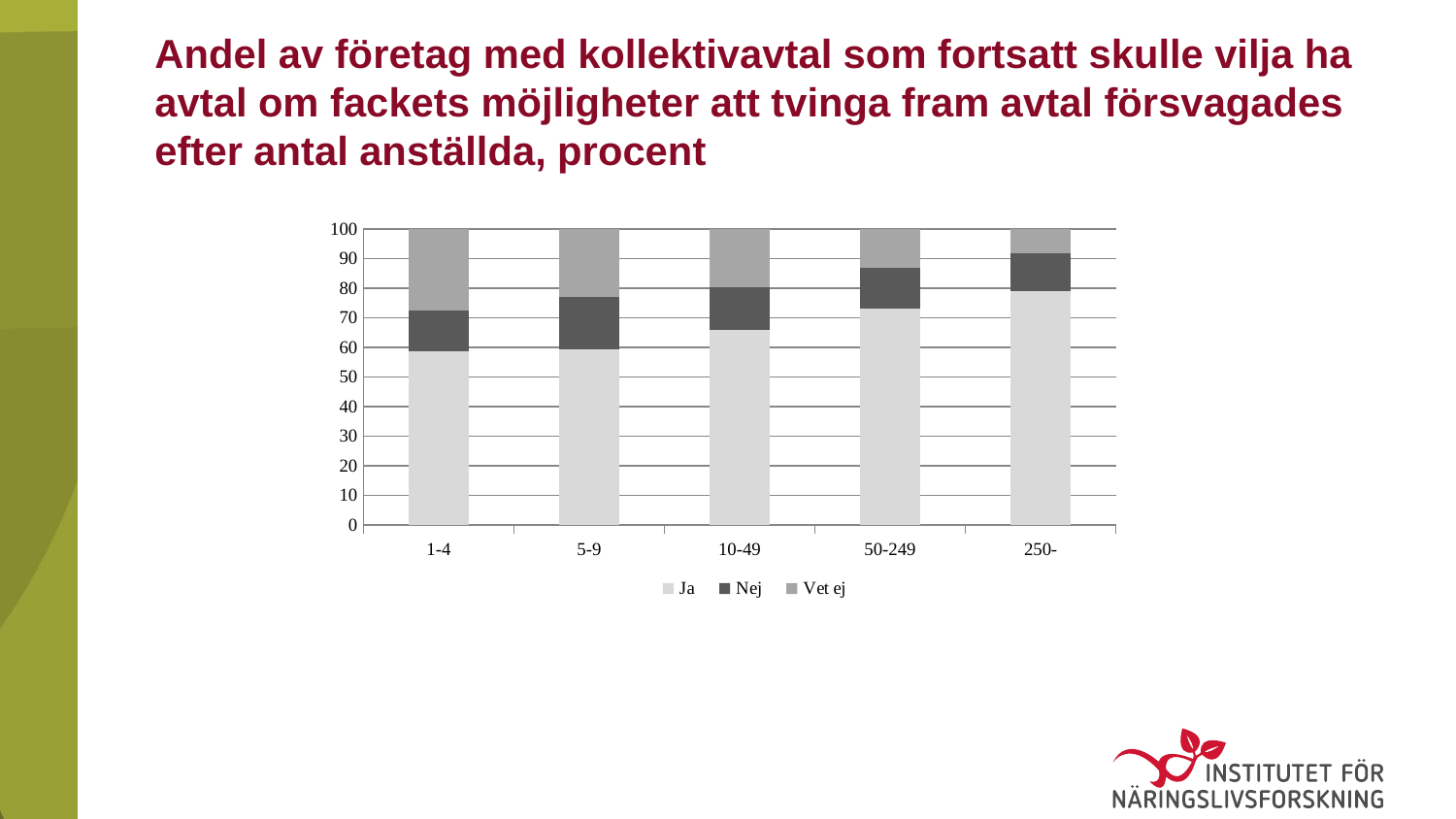
How many series does the legend list? 3 What kind of chart is shown on the slide? Stacked bar chart Is the 'Ja' share for the 250- category greater or less than 70? greater What are the three series listed in the legend? Ja, Nej, Vet ej Which category has the largest 'Ja' share? 250- Which category has the smallest 'Vet ej' share? 250- Does the 'Ja' share rise or fall as company size increases from 1-4 to 250-? rise Which category has the largest 'Vet ej' share? 1-4 Which category has a larger 'Ja' share, 1-4 or 250-? 250- Is the 'Ja' share for the 50-249 category greater or less than 60? greater Is the 'Ja' share for the 1-4 category greater or less than 70? less How many employee-size categories are shown on the x axis? 5